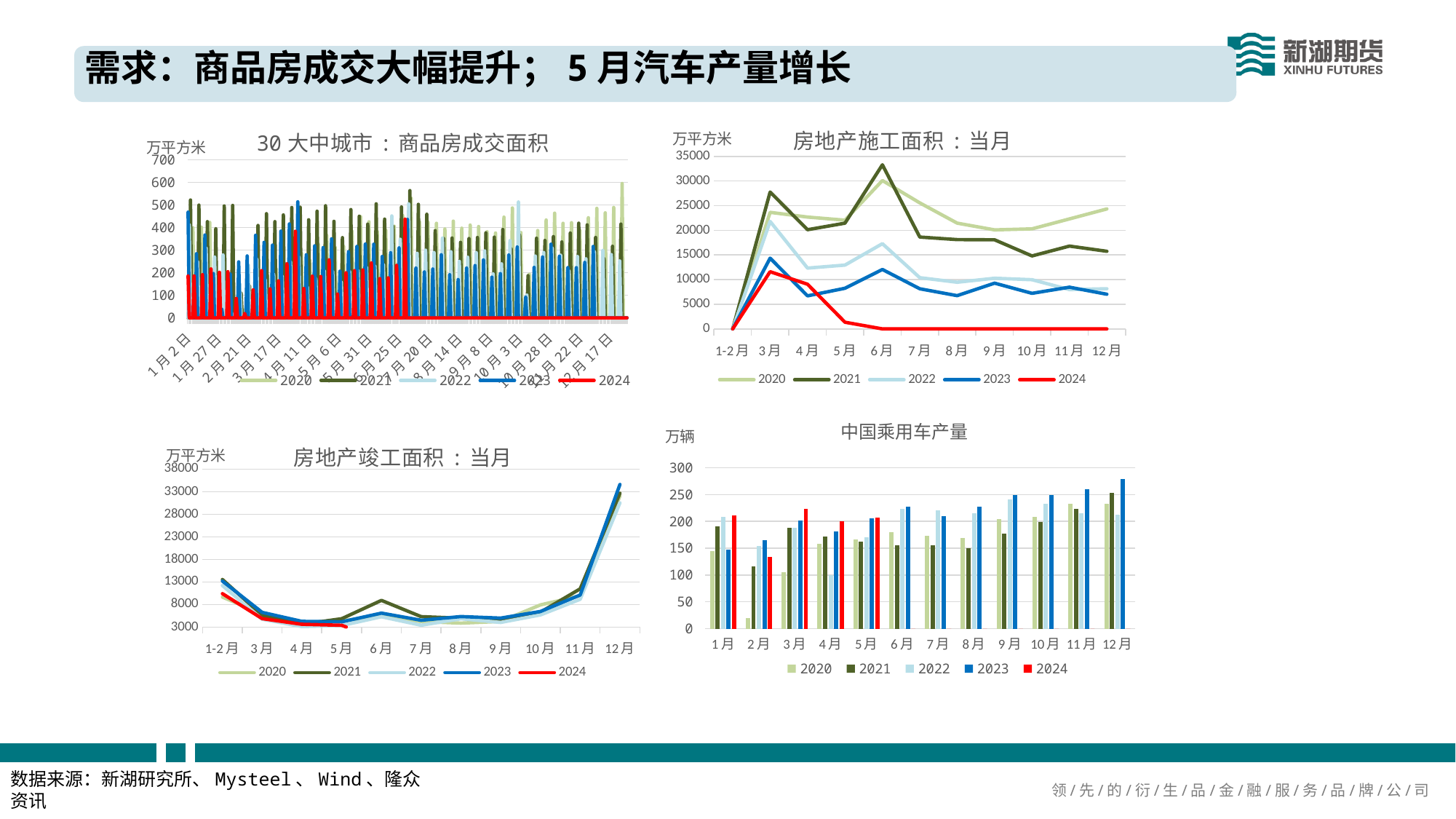
In the "中国乘用车产量" chart, which is larger for 2月: the 2020 value or the 2021 value? 2021 How many series does the legend of the "房地产竣工面积：当月" chart list? 5 What kind of chart is the "房地产施工面积：当月" chart at the top right? line chart In the "房地产施工面积：当月" chart, is the 2024 value for 6月 greater or less than 5000? less In the "中国乘用车产量" chart, is the 2023 value for 12月 greater or less than 250? greater In the "房地产竣工面积：当月" chart, does the 2023 line rise or fall from 9月 to 12月? rise In the "中国乘用车产量" chart, is the 2020 value for 2月 greater or less than 50? less What unit is shown on the y axis of the "中国乘用车产量" chart? 万辆 What kind of chart is the "中国乘用车产量" chart at the bottom right? bar chart In the "房地产施工面积：当月" chart, which month has the highest 2021 value? 6月 How many months are shown on the x axis of the "中国乘用车产量" chart? 12